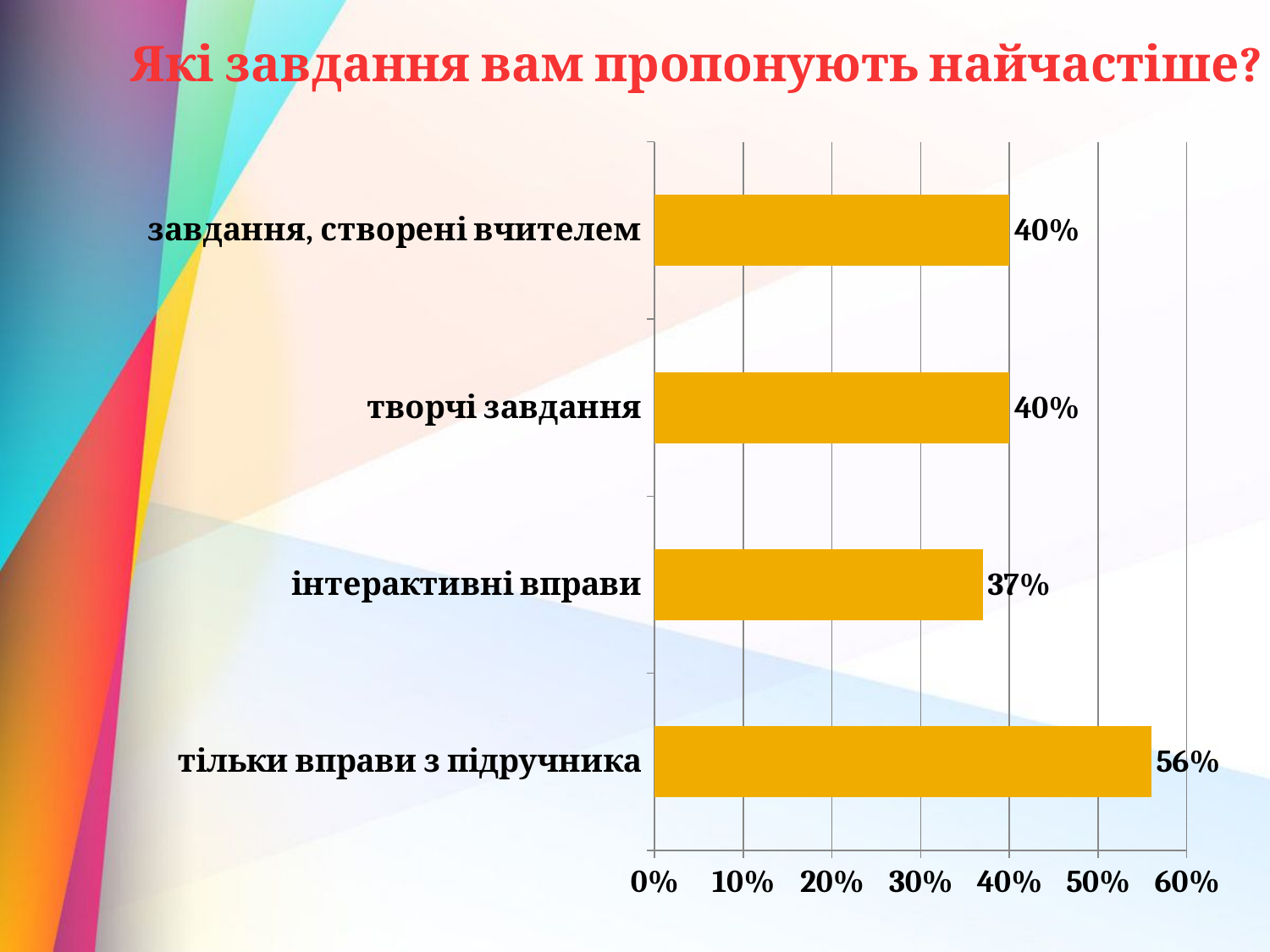
Is the value for "тільки вправи з підручника" greater or less than 50%? greater What is the difference between the values for "тільки вправи з підручника" and "інтерактивні вправи"? 19% How many categories are shown in the chart? 4 Which category has the highest value? тільки вправи з підручника What is the value for "інтерактивні вправи"? 37% Which is larger, the value for "тільки вправи з підручника" or the value for "творчі завдання"? тільки вправи з підручника What is the difference between the values for "творчі завдання" and "інтерактивні вправи"? 3% What is the value for "завдання, створені вчителем"? 40% What is the value for "творчі завдання"? 40% What is the value for "тільки вправи з підручника"? 56% Which category has the lowest value? інтерактивні вправи What kind of chart is shown on the slide? bar chart